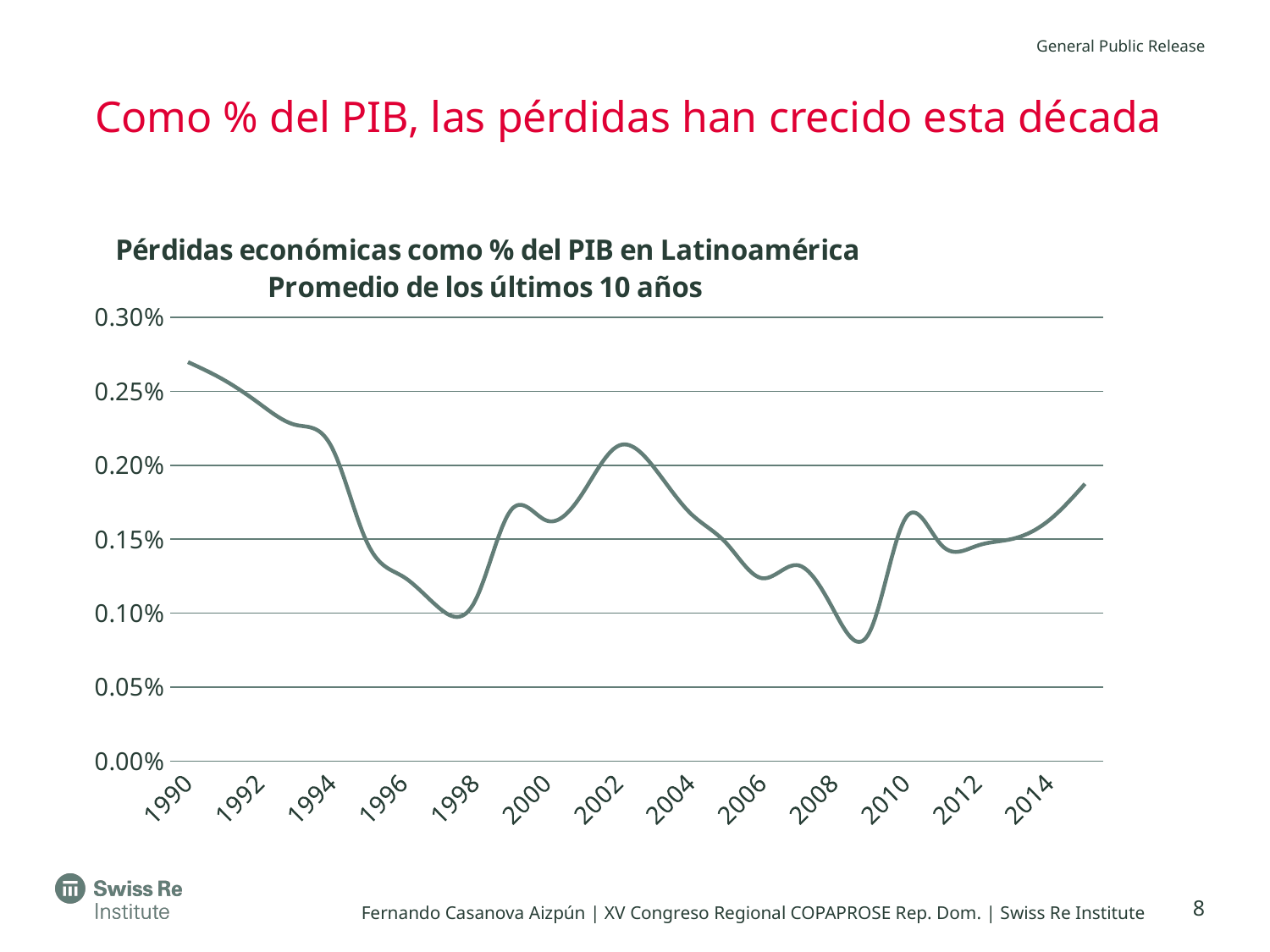
Is the value for 1990 greater or less than 0.25%? greater Is the value for 2014 greater or less than 0.15%? greater Is the value for 1996 greater or less than 0.15%? less Does the line rise or fall between 1990 and 1998? fall What is the highest value shown on the y axis? 0.30% What is the title of the chart? Pérdidas económicas como % del PIB en Latinoamérica Promedio de los últimos 10 años What kind of chart is shown on the slide? line chart In which labelled year does the line reach its highest value? 1990 How many year labels are shown on the x axis? 13